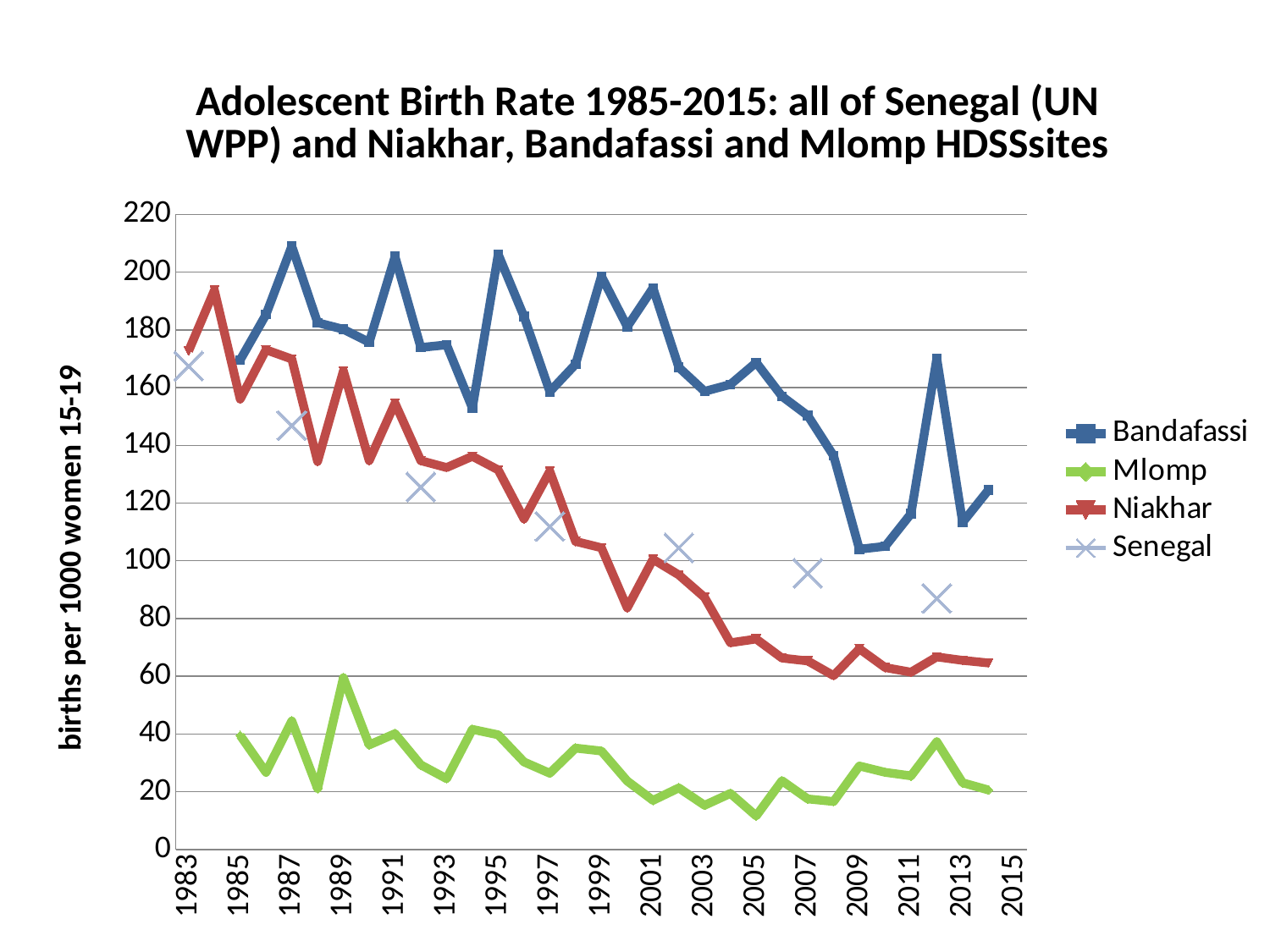
Is the value for Bandafassi in 1987 greater or less than 200? greater Is the value for Niakhar in 1983 greater or less than 180? less Which series has the lowest values across the whole period? Mlomp Is the value for Senegal in 2012 greater or less than 100? less Which series is plotted with X markers rather than a line? Senegal In 2005, which is larger, the value for Bandafassi or the value for Niakhar? Bandafassi How many series does the legend list? 4 Does the Niakhar series generally rise or fall from 1983 to 2014? fall What kind of chart is shown on the slide? line chart What is the label on the vertical axis? births per 1000 women 15-19